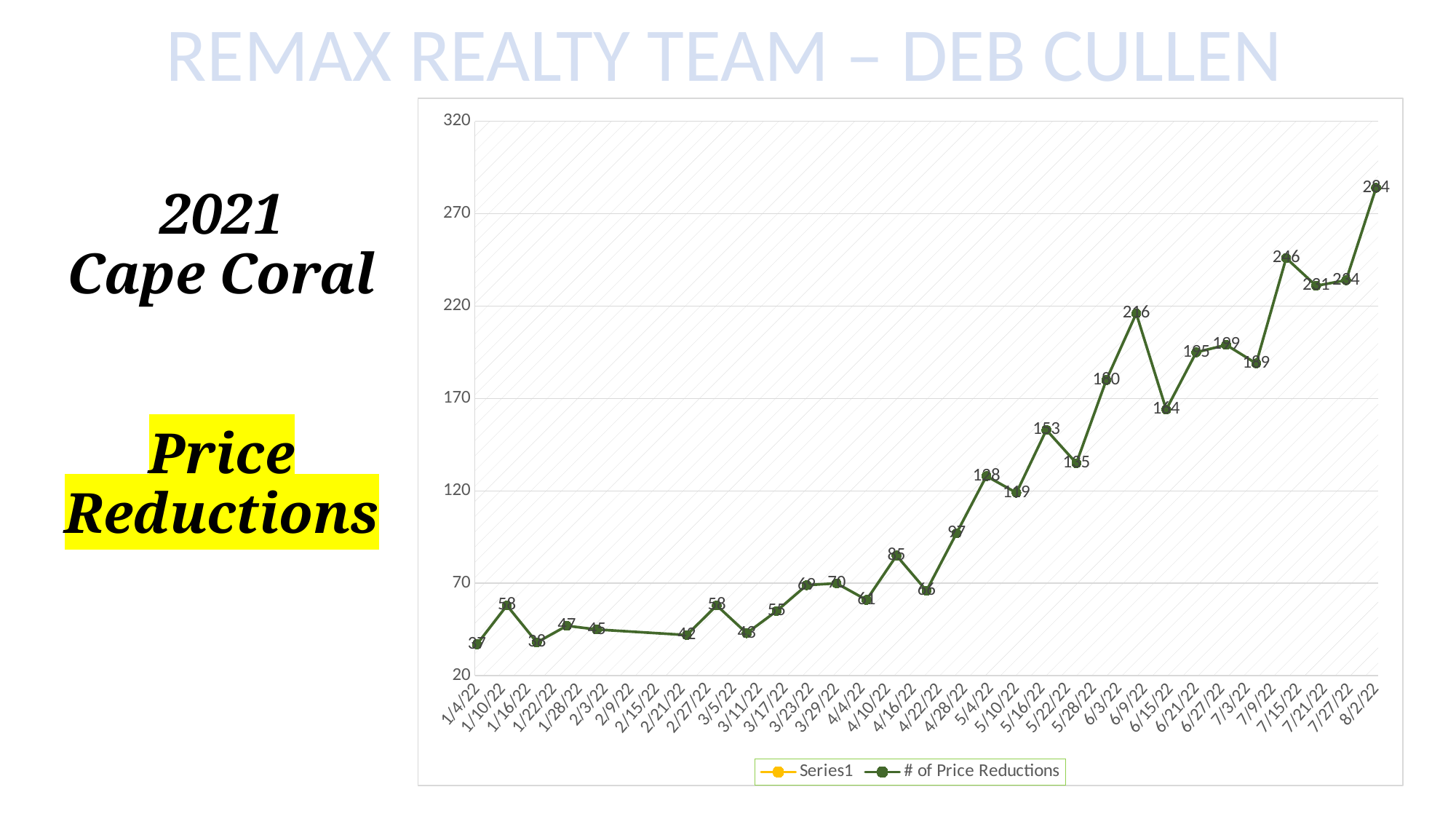
What are the two entries in the chart legend? Series1 and # of Price Reductions What is the difference between the highest labeled value (284) and the second-highest labeled value (246)? 38 Is the value for 8/2/22 greater or less than 270? greater How many series does the legend list? 2 Is the value for 1/4/22 greater or less than 70? less What is the highest value labeled on the chart? 284 Overall, do the values rise or fall from 1/4/22 to 8/2/22? rise What kind of chart is shown on the slide? line chart Which is larger, the value at 1/4/22 or the value at 8/2/22? 8/2/22 What is the first date shown on the x axis? 1/4/22 On which date does the number of price reductions reach its highest value? 8/2/22 What is the value of the last data point, at 8/2/22? 284